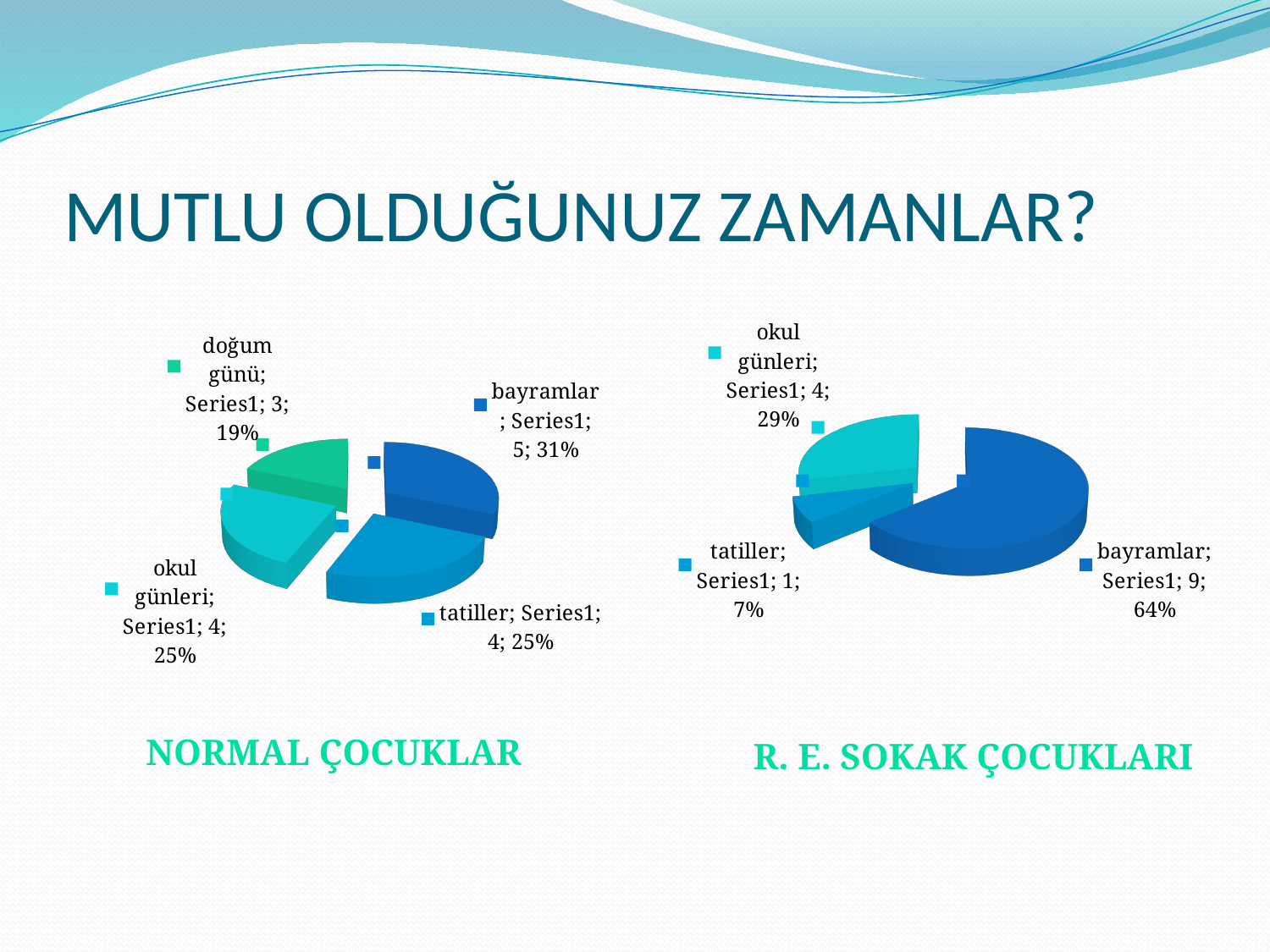
In the R. E. SOKAK ÇOCUKLARI chart, which category has the lowest value? tatiller In the NORMAL ÇOCUKLAR chart, what value is shown for bayramlar? 5 In the R. E. SOKAK ÇOCUKLARI chart, what percentage share does tatiller have? 7% Which is larger: the bayramlar value in the NORMAL ÇOCUKLAR chart or the bayramlar value in the R. E. SOKAK ÇOCUKLARI chart? R. E. SOKAK ÇOCUKLARI How many slices does the R. E. SOKAK ÇOCUKLARI pie chart have? 3 In the NORMAL ÇOCUKLAR chart, which category has the highest value? bayramlar In the NORMAL ÇOCUKLAR chart, which category has the lowest value? doğum günü In the NORMAL ÇOCUKLAR chart, what percentage share does doğum günü have? 19% In the R. E. SOKAK ÇOCUKLARI chart, what is the difference between the values for bayramlar and okul günleri? 5 How many slices does the NORMAL ÇOCUKLAR pie chart have? 4 In the R. E. SOKAK ÇOCUKLARI chart, what value is shown for bayramlar? 9 What type of chart is used on the left side of the slide? Pie chart